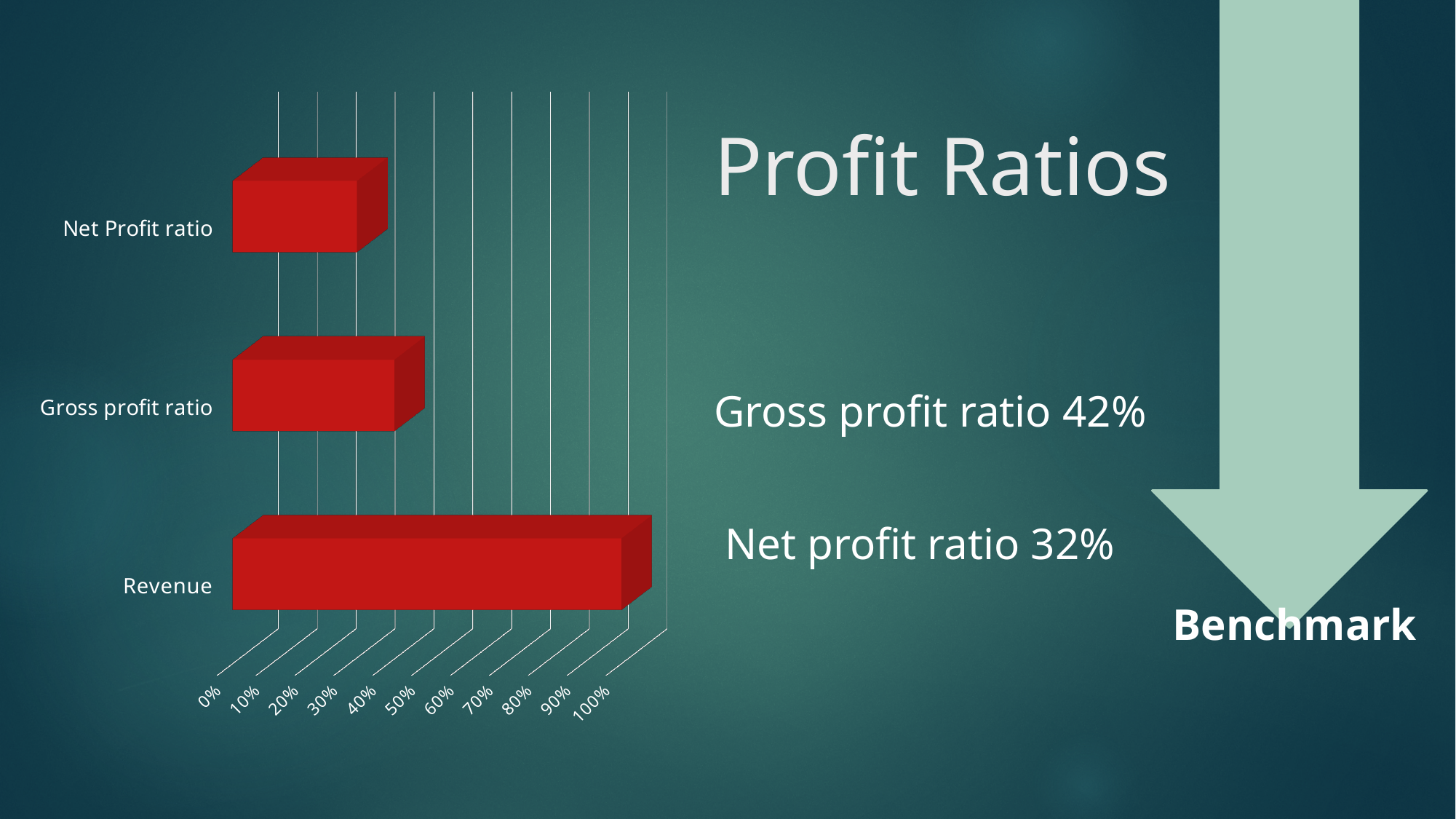
What kind of chart is shown on the slide? bar chart Is the value for Net Profit ratio greater or less than 50%? less What is the gross profit ratio stated on the slide? 42% What is the title shown on the slide next to the chart? Profit Ratios How many categories are plotted in the chart? 3 Which category has the longest bar in the chart? Revenue What is the net profit ratio stated on the slide? 32% What colour are the bars in the chart? red Is the value for Revenue greater or less than 90%? greater Which category has the shortest bar in the chart? Net Profit ratio What is the difference between the gross profit ratio and the net profit ratio stated on the slide? 10% Which is larger, the bar for Gross profit ratio or the bar for Net Profit ratio? Gross profit ratio